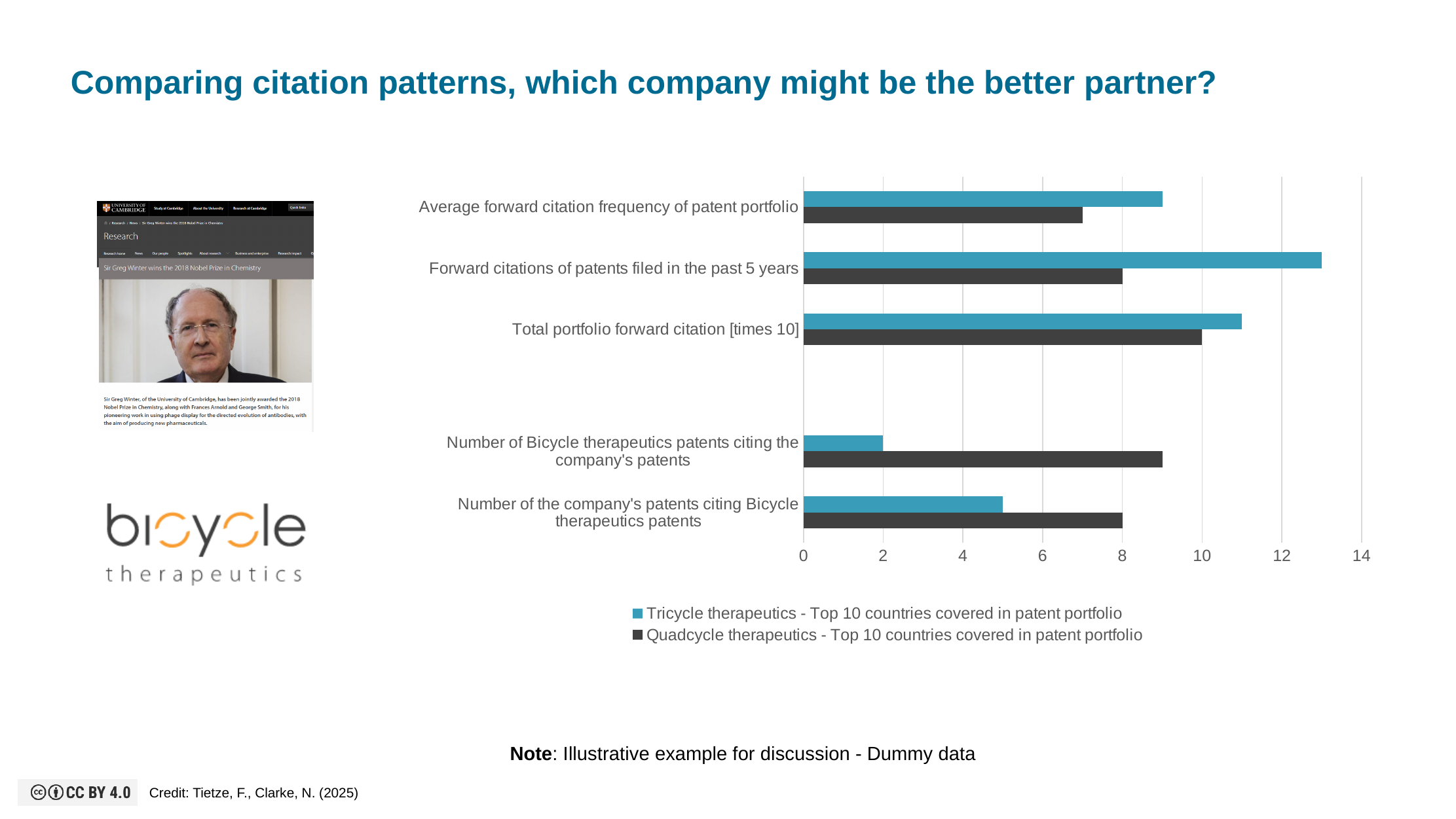
For which category does Tricycle therapeutics have its highest value? Forward citations of patents filed in the past 5 years How many labelled categories are shown on the chart's vertical axis? 5 How many series does the chart legend list? 2 Is the Quadcycle therapeutics value for 'Average forward citation frequency of patent portfolio' greater or less than 8? less Is the Tricycle therapeutics value for 'Forward citations of patents filed in the past 5 years' greater or less than 12? greater For which category does Tricycle therapeutics have its lowest value? Number of Bicycle therapeutics patents citing the company's patents What is the value for Quadcycle therapeutics for 'Number of the company's patents citing Bicycle therapeutics patents'? 8 What is the value for Quadcycle therapeutics for 'Total portfolio forward citation [times 10]'? 10 For 'Number of Bicycle therapeutics patents citing the company's patents', which series has the larger value, Tricycle therapeutics or Quadcycle therapeutics? Quadcycle therapeutics What type of chart is shown on the slide? Bar chart What is the value for Quadcycle therapeutics for 'Forward citations of patents filed in the past 5 years'? 8 What is the value for Tricycle therapeutics for 'Number of Bicycle therapeutics patents citing the company's patents'? 2